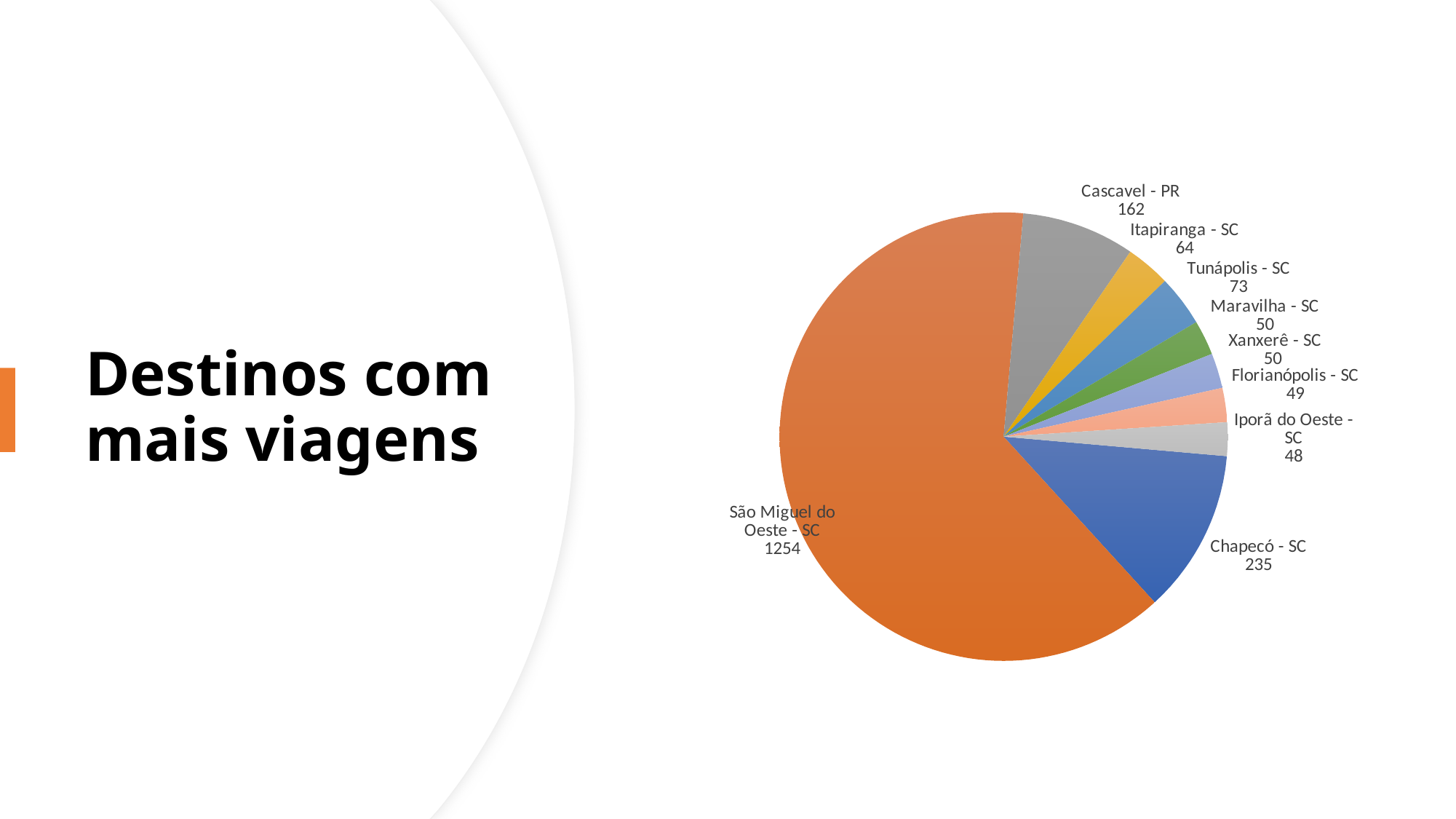
Which destination has the smallest value in the pie chart? Iporã do Oeste - SC How many destinations (slices) are shown in the pie chart? 9 What is the value for Tunápolis - SC? 73 Which has a larger value, Tunápolis - SC or Itapiranga - SC? Tunápolis - SC What type of chart is shown on the slide? Pie chart Which destination has the largest slice of the pie? São Miguel do Oeste - SC What is the difference between the values for Chapecó - SC and Cascavel - PR? 73 What is the difference between the values for São Miguel do Oeste - SC and Chapecó - SC? 1019 What is the value for São Miguel do Oeste - SC? 1254 What is the title of the slide containing the pie chart? Destinos com mais viagens What is the value for Chapecó - SC? 235 What is the value for Cascavel - PR? 162